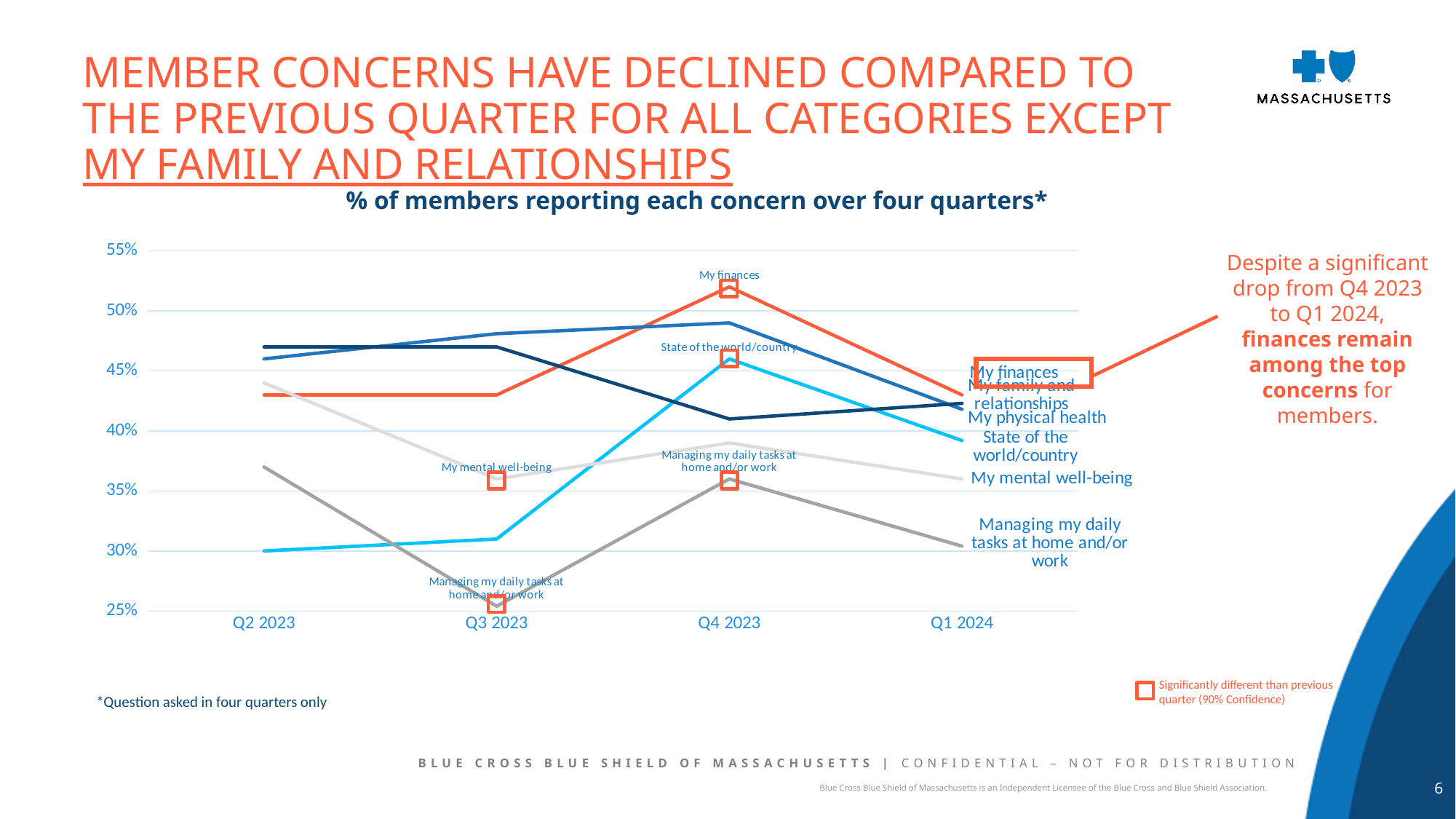
Is the value for Managing my daily tasks at home and/or work in Q3 2023 greater or less than 30%? less Is the value for My mental well-being in Q2 2023 greater or less than 40%? greater Which concern has the highest value in Q4 2023? My finances In Q4 2023, which is larger: My finances or My mental well-being? My finances Which concern has the lowest value in Q1 2024? Managing my daily tasks at home and/or work Is the value for My finances in Q4 2023 greater or less than 50%? greater What is the title of the chart? % of members reporting each concern over four quarters* How many quarters are plotted along the x axis? 4 Which concern has the lowest value in Q3 2023? Managing my daily tasks at home and/or work How many concern series are plotted in the chart? 6 Does the value for My finances rise or fall from Q4 2023 to Q1 2024? Fall What kind of chart is shown on the slide? Line chart